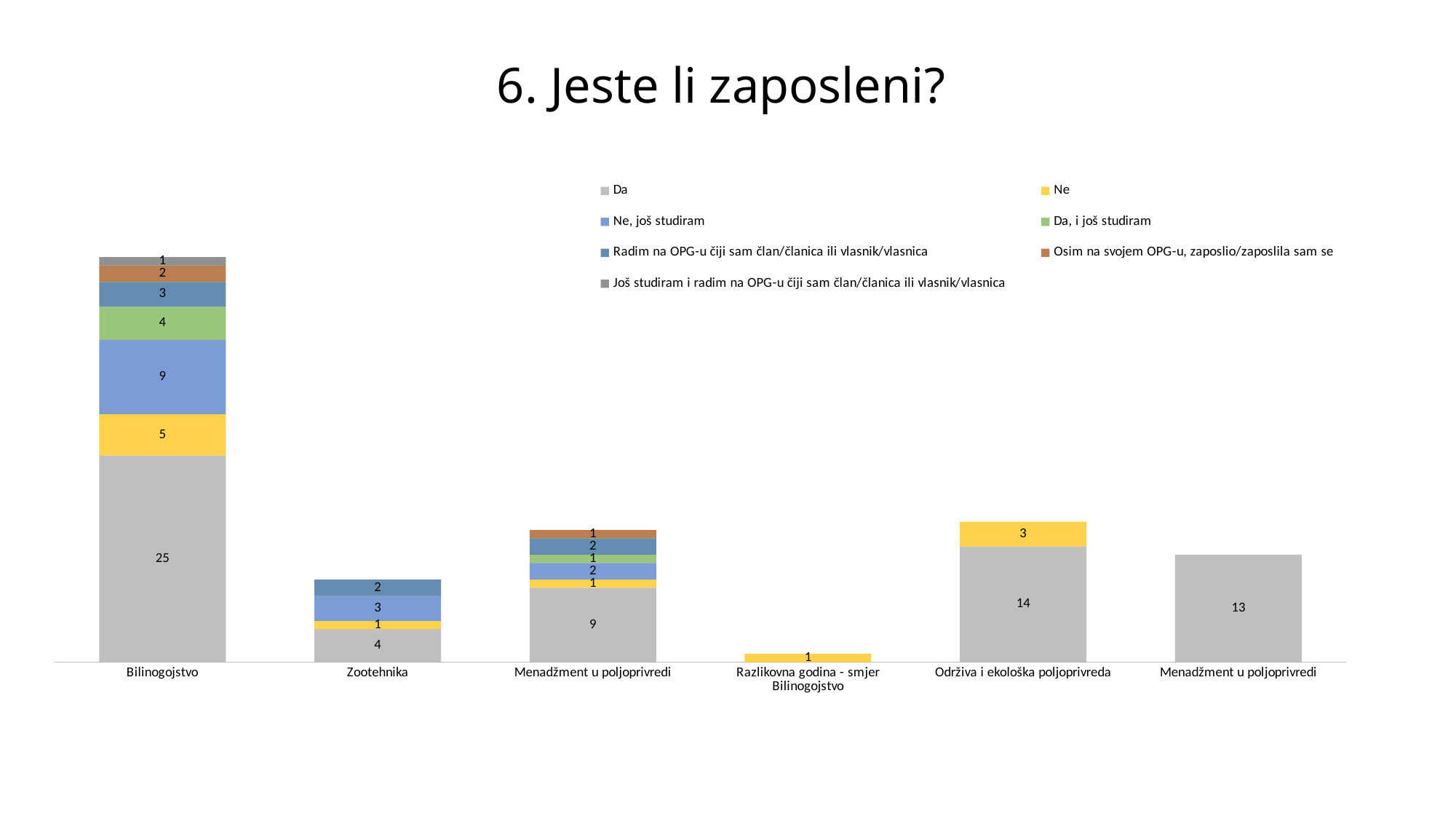
What is the value for "Ne, još studiram" in the Bilinogojstvo bar? 9 Which category has the tallest stacked bar? Bilinogojstvo What is the value for "Radim na OPG-u čiji sam član/članica ili vlasnik/vlasnica" in the Zootehnika bar? 2 What is the total of the stacked bar for Zootehnika? 10 Which category has the shortest stacked bar? Razlikovna godina - smjer Bilinogojstvo What kind of chart is shown on the slide? stacked bar chart How many series does the legend list? 7 What is the value for "Ne" in the Održiva i ekološka poljoprivreda bar? 3 How many categories are shown on the x axis? 6 What is the difference between the "Da" value for Bilinogojstvo and the "Da" value for Održiva i ekološka poljoprivreda? 11 What is the value for "Da" in the Bilinogojstvo bar? 25 What is the total of the stacked bar for Održiva i ekološka poljoprivreda? 17